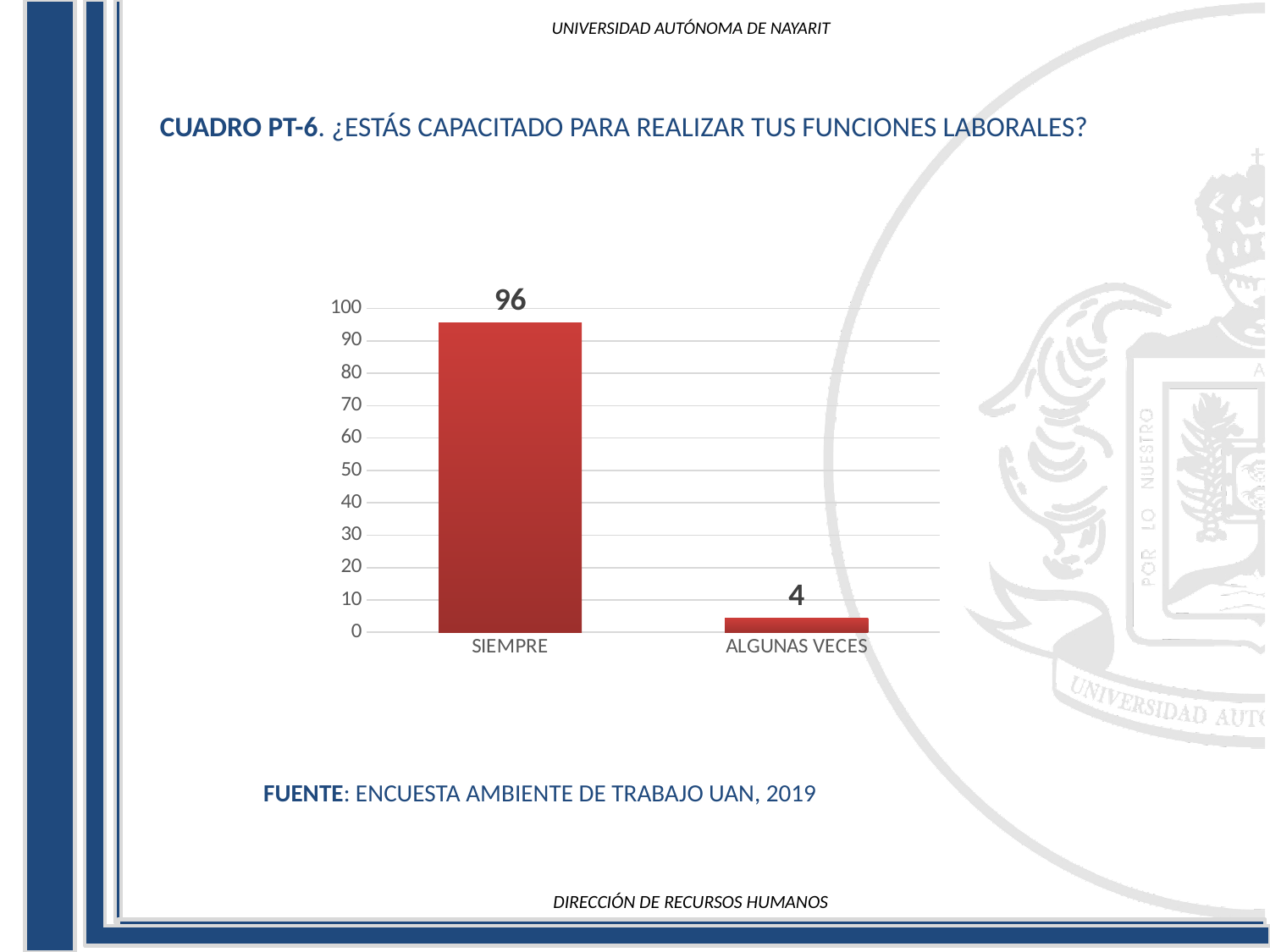
What is the total of the two values shown in the chart? 100 What kind of chart is shown on the slide? bar chart What is the difference between the values for SIEMPRE and ALGUNAS VECES? 92 What is the value for SIEMPRE? 96 What is the source cited below the chart? ENCUESTA AMBIENTE DE TRABAJO UAN, 2019 What is the value for ALGUNAS VECES? 4 Is the value for SIEMPRE greater or less than 90? greater Which is larger, the value for SIEMPRE or the value for ALGUNAS VECES? SIEMPRE Is the value for ALGUNAS VECES greater or less than 10? less Which category has the lowest value? ALGUNAS VECES Which category has the highest value? SIEMPRE How many categories are shown on the x axis? 2